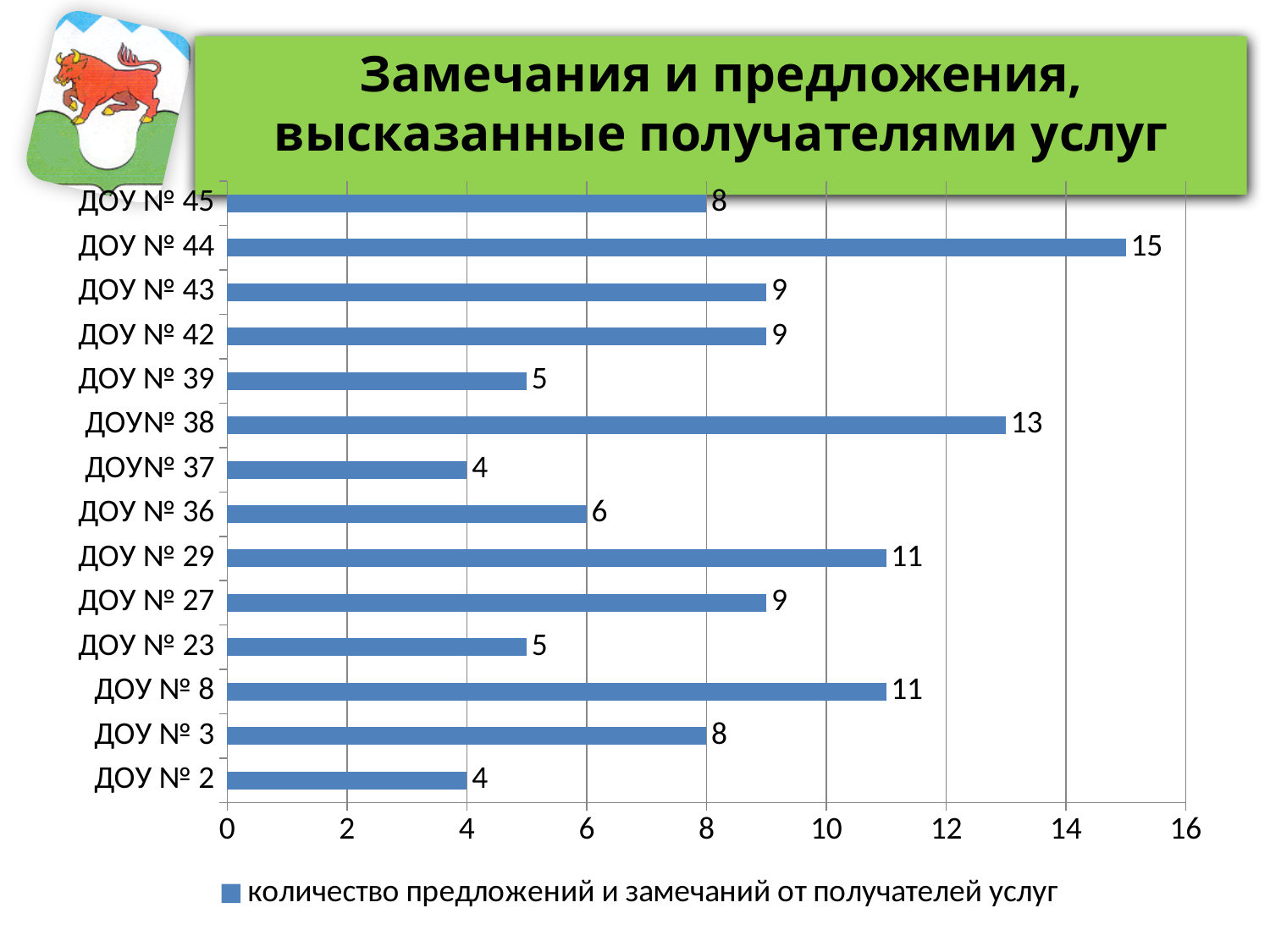
What kind of chart is shown on the slide? bar chart How many categories are shown in the chart? 14 What is the difference between the values for ДОУ № 29 and ДОУ № 36? 5 Which is larger, the value for ДОУ № 23 or the value for ДОУ № 3? ДОУ № 3 What is the value for ДОУ № 44? 15 What is the value for ДОУ № 8? 11 What is the value for ДОУ № 39? 5 What is the difference between the values for ДОУ № 44 and ДОУ № 45? 7 How many series does the legend list? 1 Which is larger, the value for ДОУ№ 38 or the value for ДОУ № 43? ДОУ№ 38 Which category has the highest value? ДОУ № 44 What is the value for ДОУ№ 38? 13